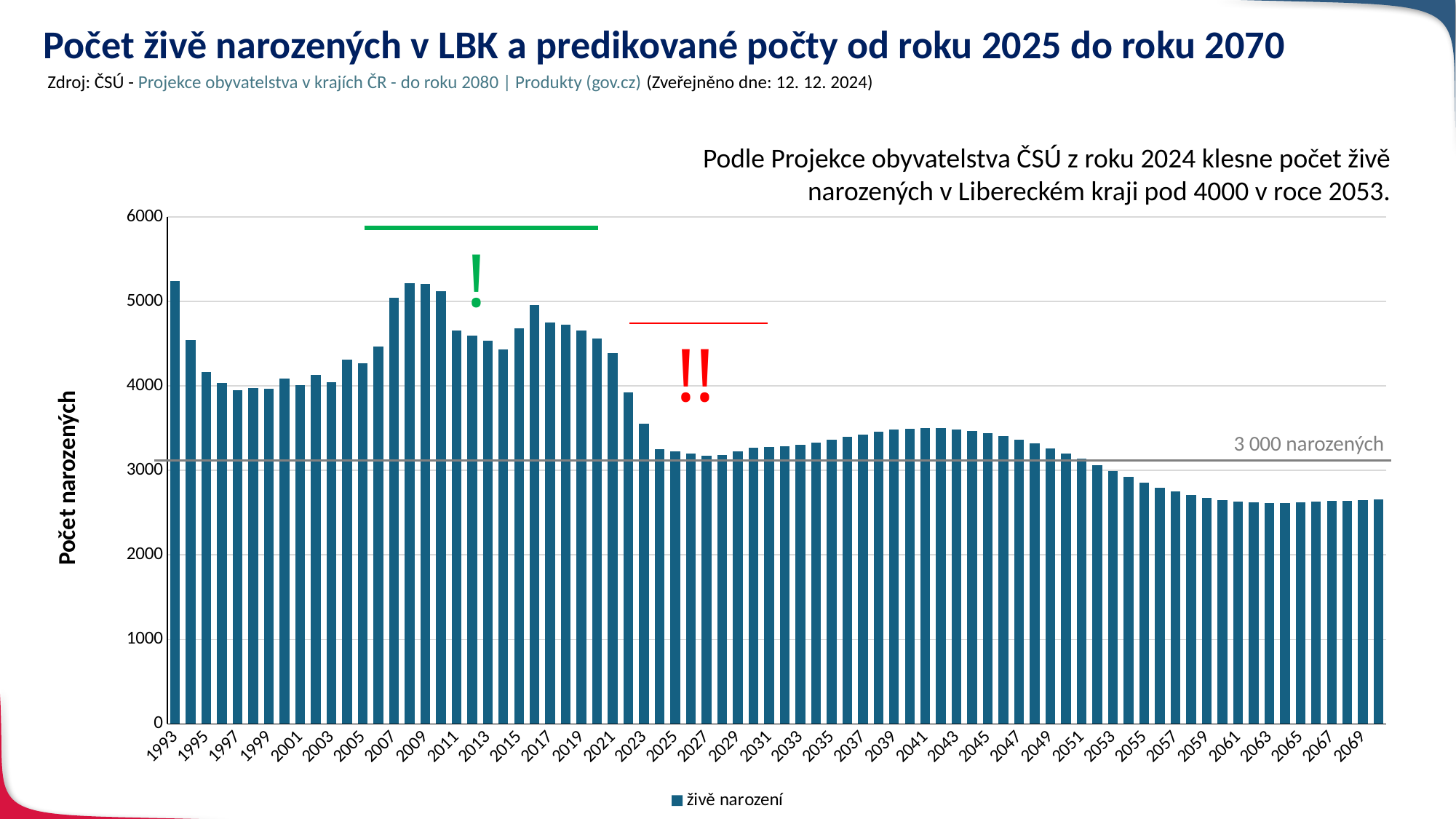
Which year has the larger value, 2008 or 2022? 2008 Is the value for 2022 greater or less than 4000? less What label is written next to the horizontal reference line on the chart? 3 000 narozených How many series does the legend list? 1 What is the name of the series shown in the legend? živě narození Is the value for 2060 greater or less than 3000? less Is the value for 2043 greater or less than 4000? less Which year has the larger value, 2041 or 2060? 2041 Do the values rise or fall from 2043 to 2070? fall What kind of chart is shown on the slide? bar chart